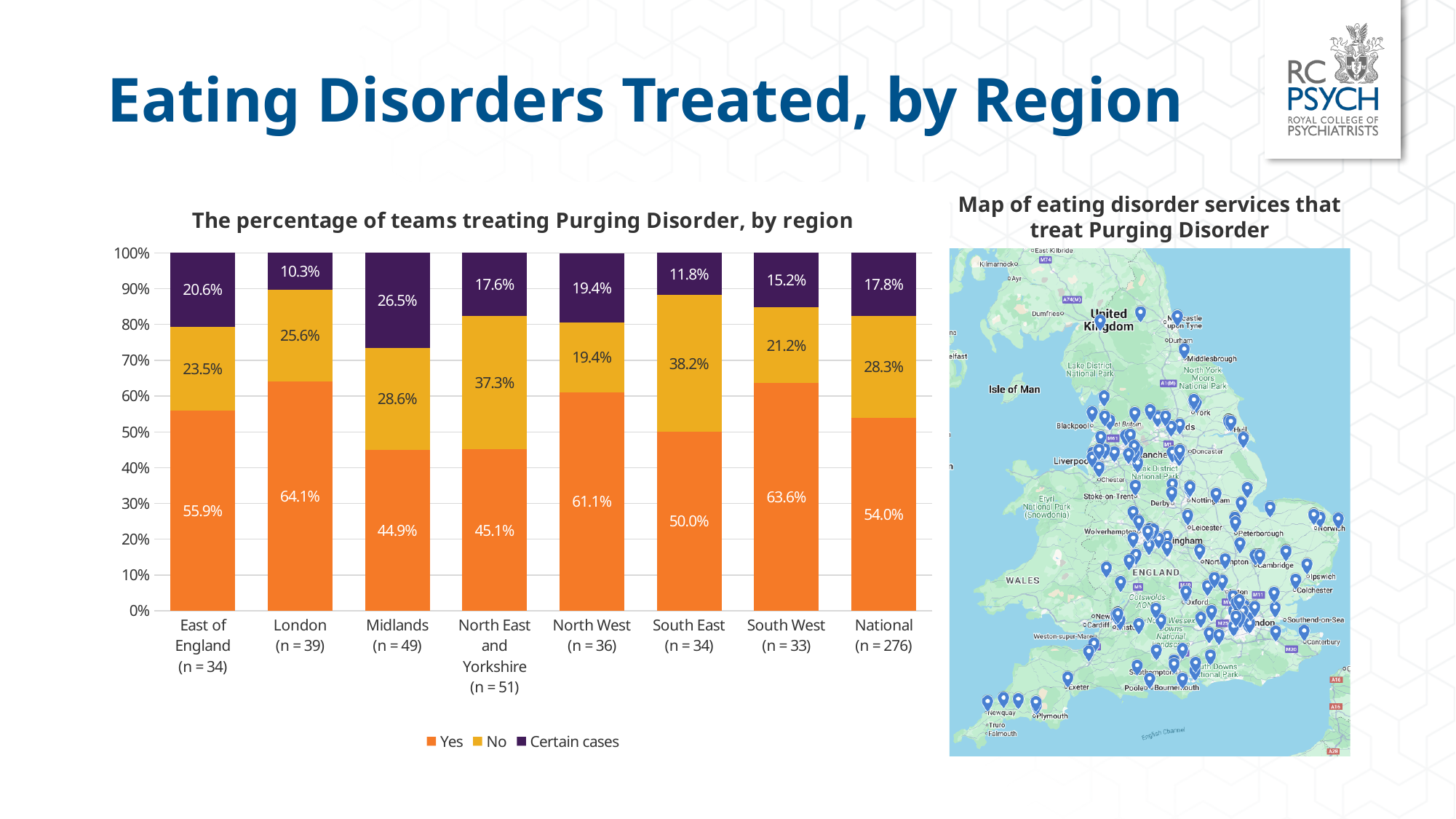
What is the 'Certain cases' percentage for the Midlands? 26.5% What is the difference in percentage points between the 'Yes' values for London and the Midlands? 19.2 How many regions (including National) are shown on the x axis of the chart? 8 What is the 'No' percentage for the South East? 38.2% What is the National 'Yes' percentage? 54.0% Which has a larger 'Certain cases' percentage, East of England or South West? East of England Which region has the highest 'Yes' percentage? London How many series does the chart legend list? 3 What percentage of teams in London answered Yes to treating Purging Disorder? 64.1% What type of chart is used to show the percentage of teams treating Purging Disorder? Stacked bar chart Which region has the highest 'No' percentage? South East Which region has the lowest 'Certain cases' percentage? London